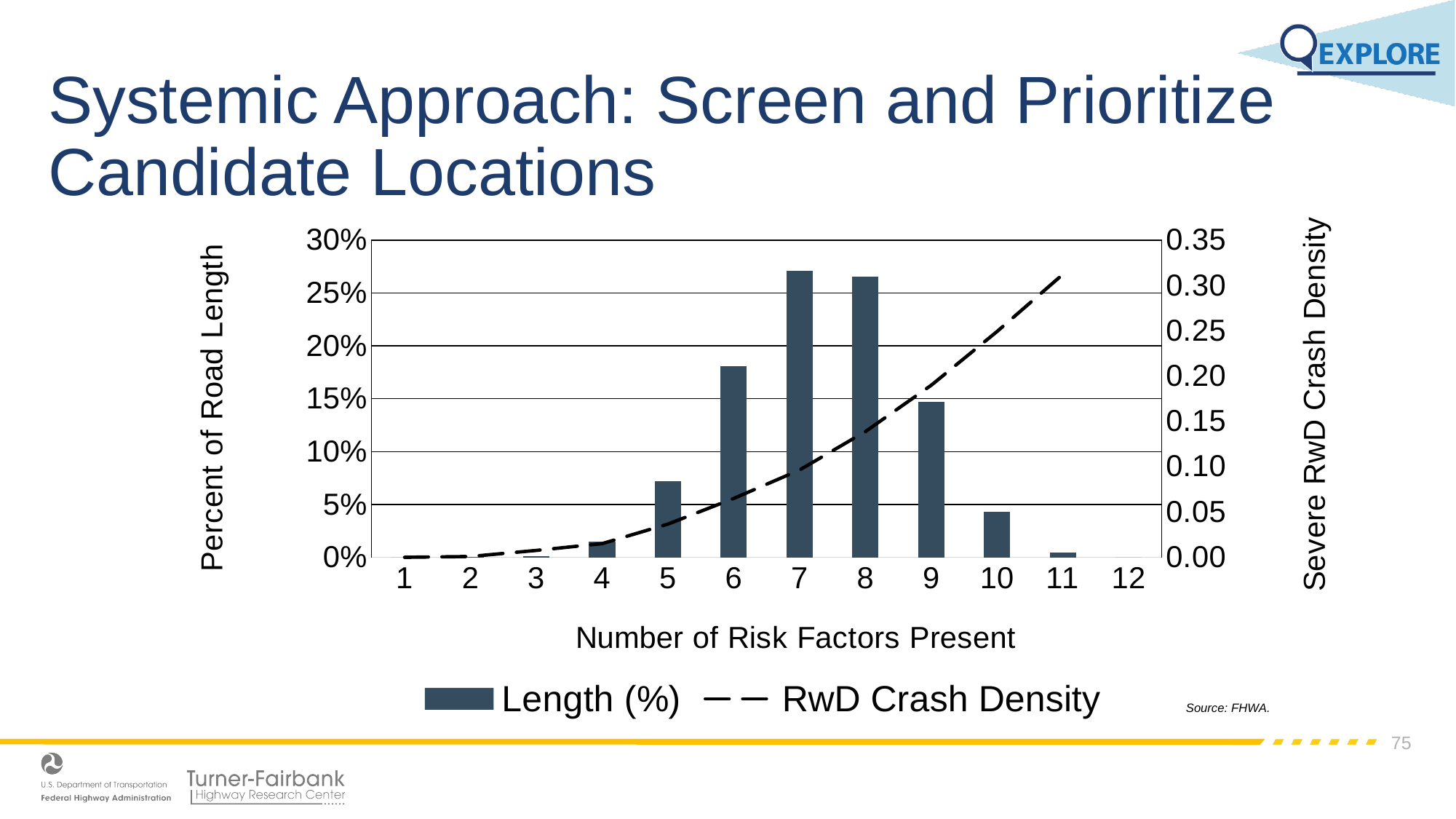
Which has a larger Length (%) value: 6 risk factors or 9 risk factors? 6 risk factors Is the Length (%) value for 6 risk factors greater or less than 15%? greater How many categories are shown on the x axis (Number of Risk Factors Present)? 12 Is the Length (%) value for 5 risk factors greater or less than 10%? less Does the RwD Crash Density line rise or fall as the number of risk factors increases? rises Is the RwD Crash Density value at 11 risk factors greater or less than 0.25? greater What is the title of the left vertical axis? Percent of Road Length What kind of chart is shown on the slide? A combination bar and line chart How many series does the legend list? 2